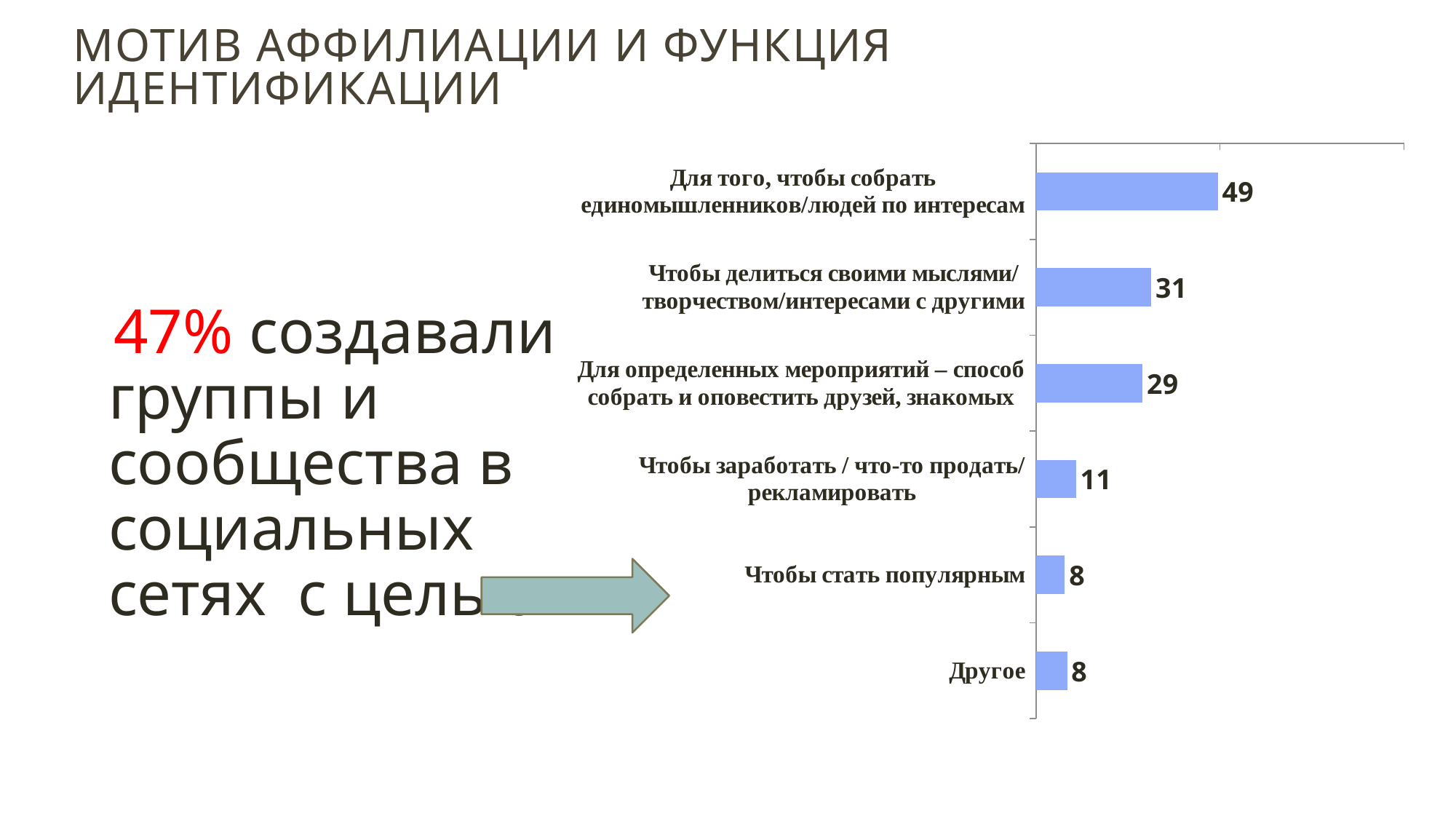
What is the difference between the values for "Для определенных мероприятий – способ собрать и оповестить друзей, знакомых" and "Чтобы заработать / что-то продать/рекламировать"? 18 What is the value for "Чтобы делиться своими мыслями/творчеством/интересами с другими"? 31 What is the value for "Другое"? 8 What is the value for "Для того, чтобы собрать единомышленников/людей по интересам"? 49 What kind of chart is shown on the slide? Bar chart Which category has the highest value? Для того, чтобы собрать единомышленников/людей по интересам What is the value for "Чтобы заработать / что-то продать/рекламировать"? 11 How many categories are shown in the chart? 6 What is the value for "Чтобы стать популярным"? 8 What is the difference between the values for "Для того, чтобы собрать единомышленников/людей по интересам" and "Чтобы делиться своими мыслями/творчеством/интересами с другими"? 18 What percentage is highlighted in red in the text on the left of the slide? 47% Which is larger: the value for "Чтобы делиться своими мыслями/творчеством/интересами с другими" or for "Для определенных мероприятий – способ собрать и оповестить друзей, знакомых"? Чтобы делиться своими мыслями/творчеством/интересами с другими